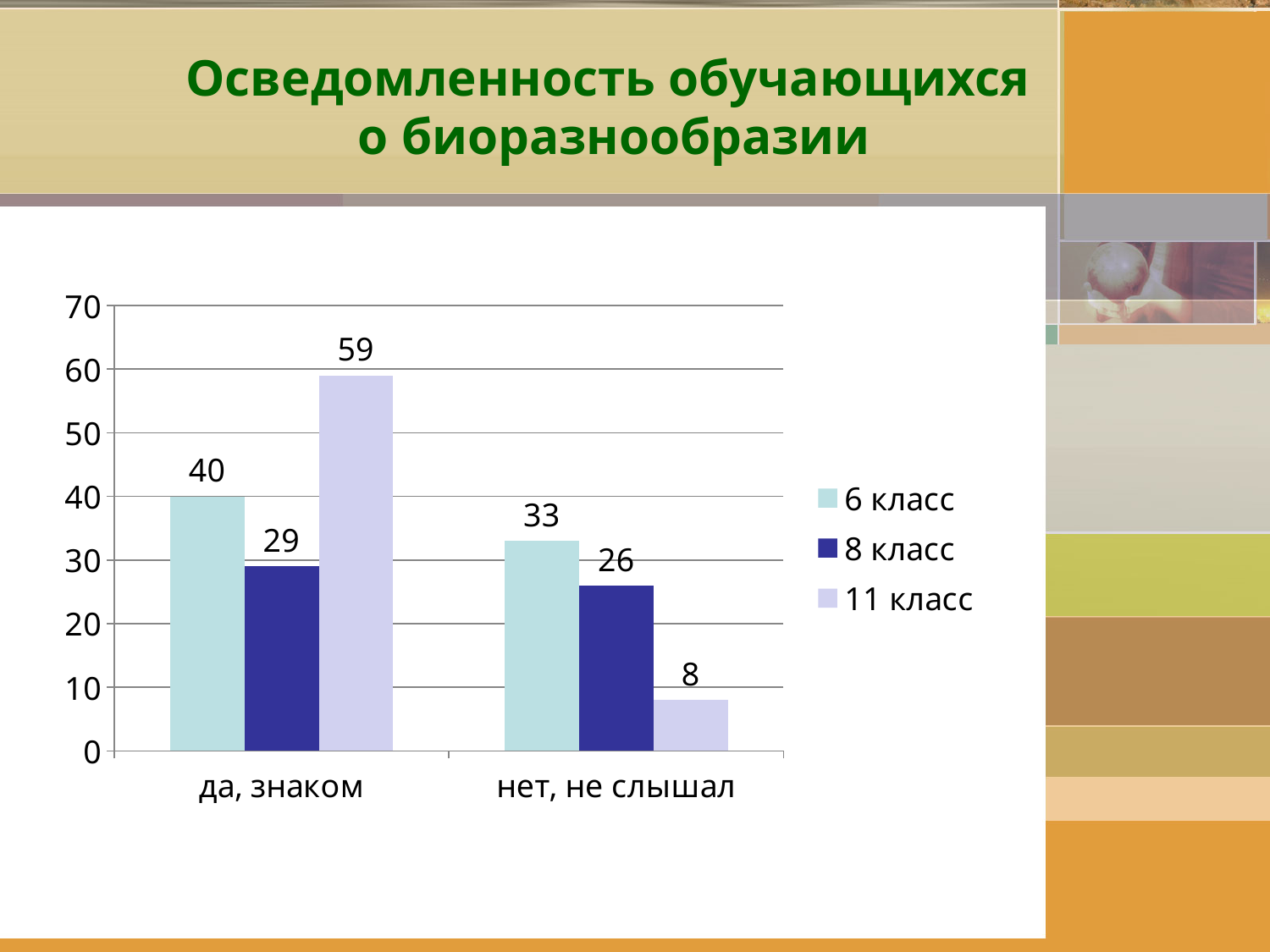
Which is larger: the 6 класс value for "да, знаком" or the 6 класс value for "нет, не слышал"? да, знаком What is the difference between the 11 класс values for "да, знаком" and "нет, не слышал"? 51 What kind of chart is shown on the slide? bar chart What is the value for 11 класс in the category "да, знаком"? 59 What is the value for 8 класс in the category "да, знаком"? 29 Which series has the highest value in the category "да, знаком"? 11 класс How many series does the legend list? 3 What is the value for 6 класс in the category "нет, не слышал"? 33 How many categories are shown on the x axis? 2 What is the title of the slide? Осведомленность обучающихся о биоразнообразии Which series has the lowest value in the category "нет, не слышал"? 11 класс Is the value for 8 класс in "нет, не слышал" greater or less than 30? less